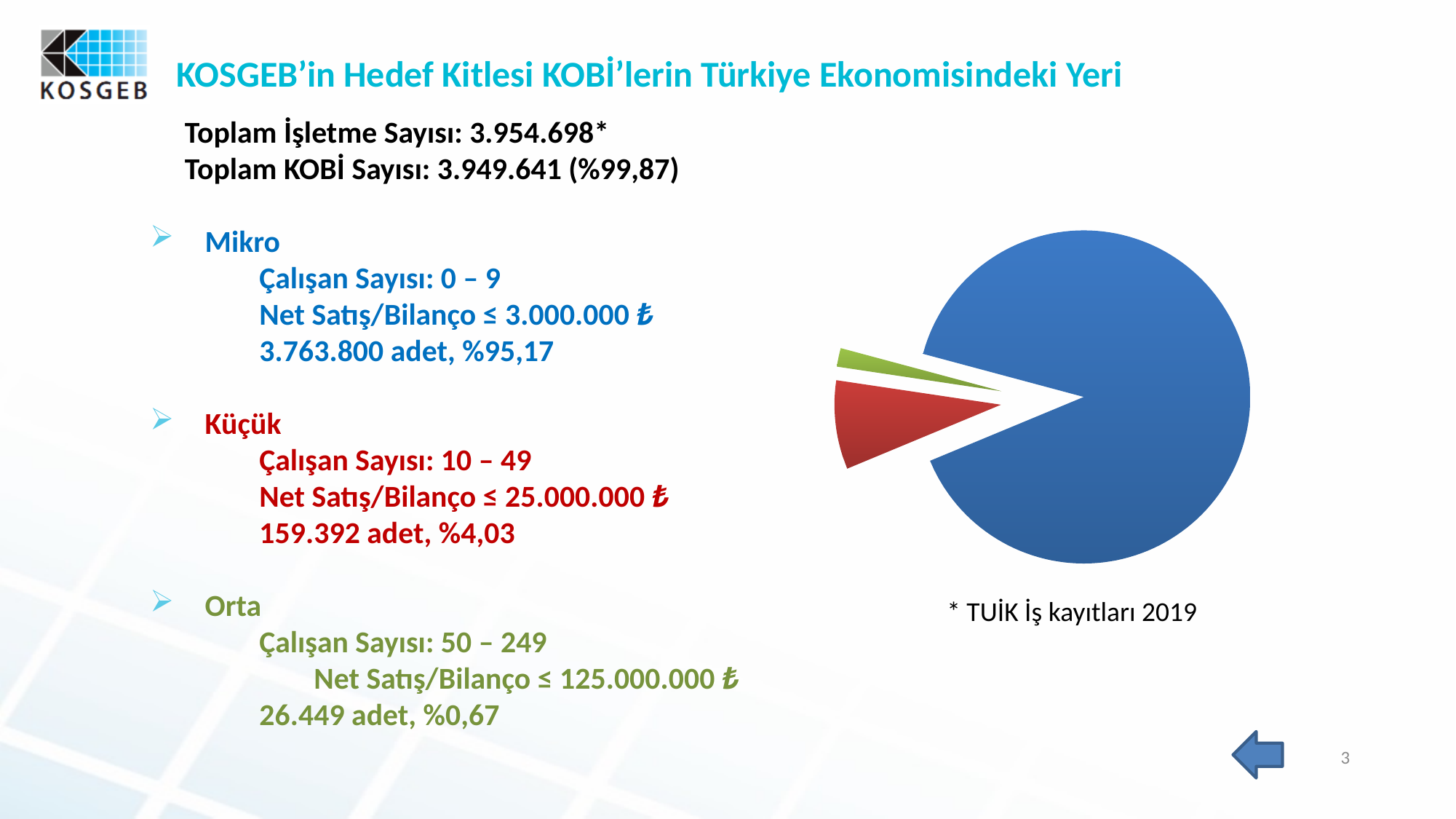
What is the difference in enterprise count between the Küçük (159.392) and Orta (26.449) categories? 132.943 What colour is the largest slice of the pie chart? blue Which enterprise category does the smallest slice of the pie chart represent? Orta How many enterprises (adet) are in the Küçük category shown by the red slice? 159.392 Which slice is larger in the pie chart, the red one (Küçük) or the green one (Orta)? red (Küçük) How many slices does the pie chart have? 3 What kind of chart is shown on the slide? pie chart Which enterprise category does the largest slice of the pie chart represent? Mikro How many enterprises (adet) are in the Orta category shown by the green slice? 26.449